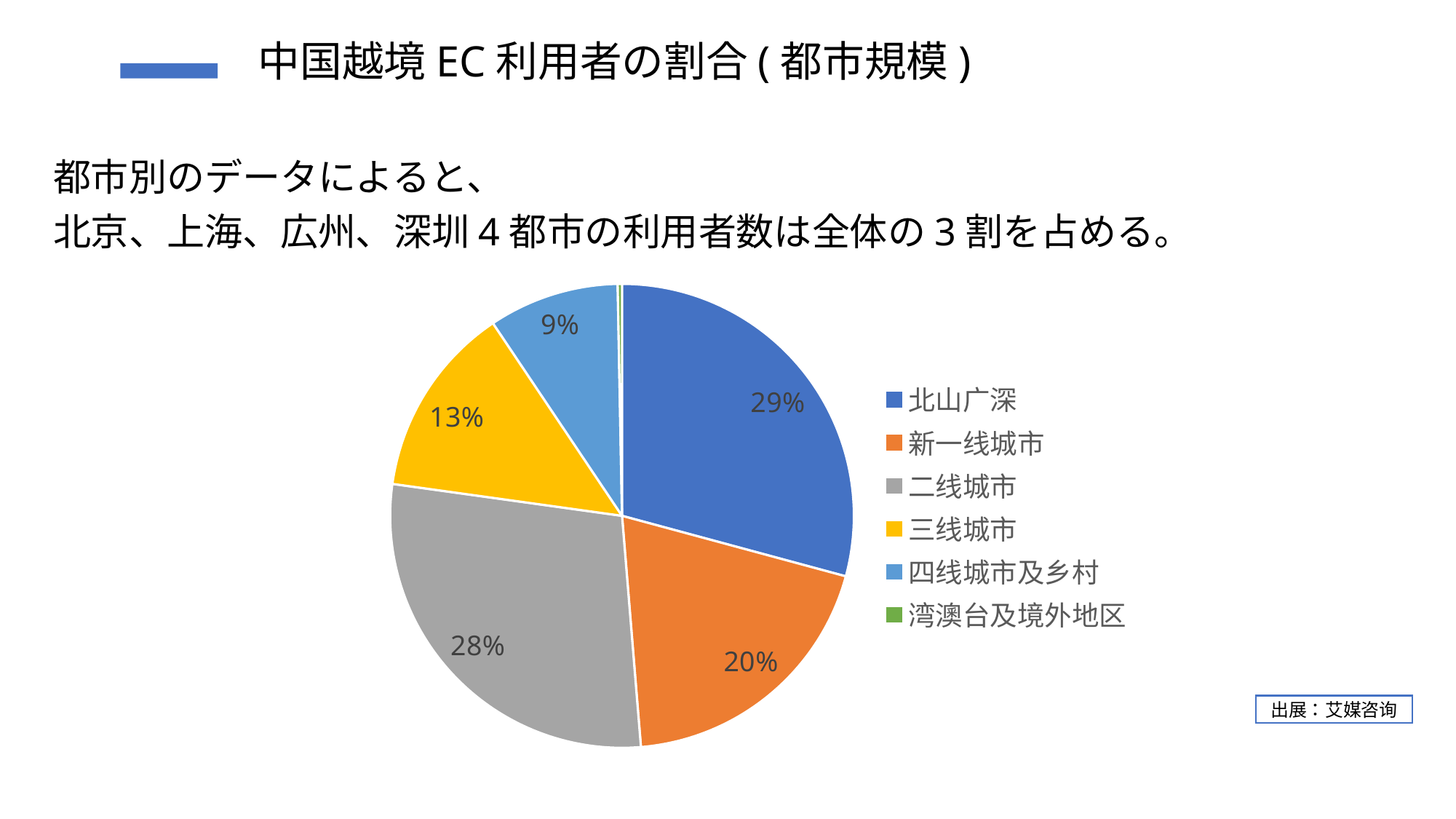
What share of the pie does 北山广深 account for? 29% What is the difference between the shares of 新一线城市 and 三线城市? 7% What is the value shown for 三线城市? 13% What is the value shown for 新一线城市? 20% What is the value shown for 二线城市? 28% What kind of chart is shown on the slide? pie chart What is the value shown for 四线城市及乡村? 9% Which is larger, the share of 二线城市 or the share of 四线城市及乡村? 二线城市 What colour is the slice for 三线城市? yellow Which category has the largest labelled share of the pie? 北山广深 Which category has the smallest slice of the pie? 湾澳台及境外地区 How many categories does the legend list? 6